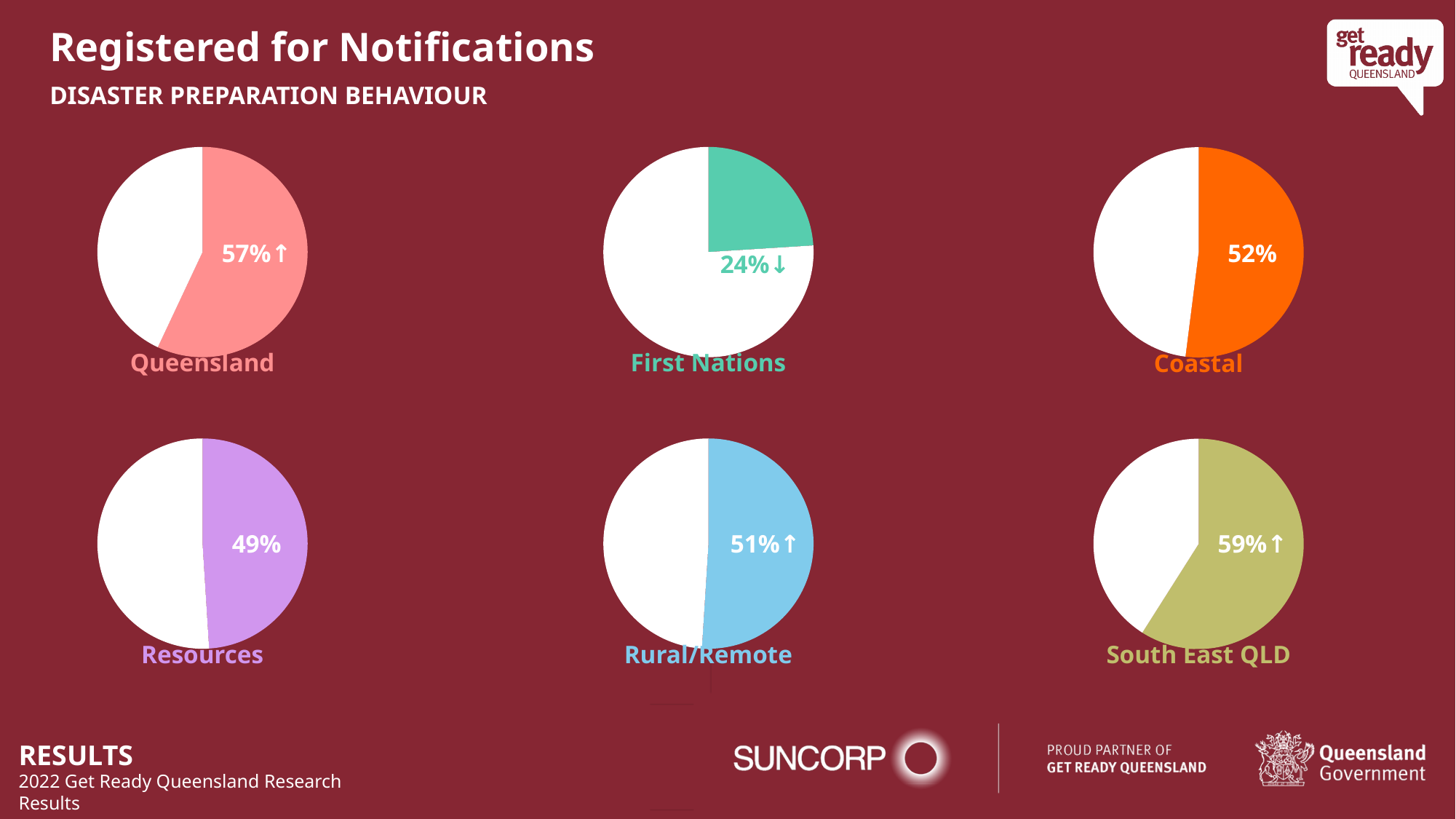
What percentage is shown on the First Nations pie chart? 24% What percentage is shown on the Resources pie chart? 49% Which group has the highest percentage registered for notifications across the six pie charts? South East QLD What is the difference between the South East QLD percentage and the First Nations percentage? 35% What percentage is shown on the Rural/Remote pie chart? 51% What percentage is shown on the Queensland pie chart? 57% What type of chart is used to show the Rural/Remote value? Pie chart Which group has the lowest percentage registered for notifications across the six pie charts? First Nations What percentage is shown on the South East QLD pie chart? 59% What percentage is shown on the Coastal pie chart? 52% Which is larger, the Coastal percentage or the Resources percentage? Coastal How many pie charts are shown on the slide? 6